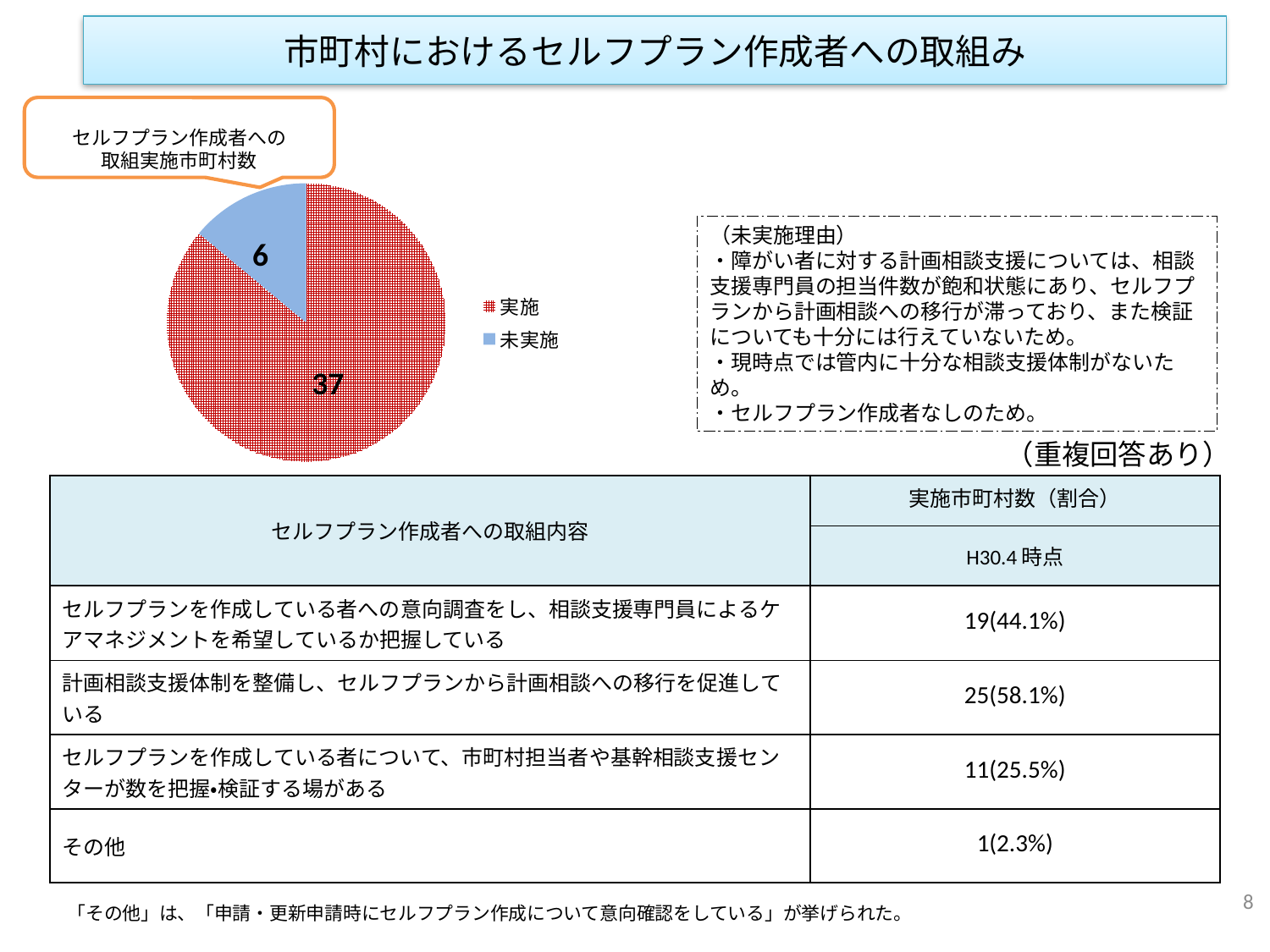
In the pie chart, what is the value for 未実施? 6 How many slices does the pie chart have? 2 Which slice of the pie chart is the largest? 実施 What is the title shown in the callout above the pie chart? セルフプラン作成者への取組実施市町村数 Which slice of the pie chart is the smallest? 未実施 What is the total of the two values shown in the pie chart? 43 What share of the pie chart does the 実施 slice represent? 86.0% How many entries does the pie chart legend list? 2 In the pie chart, what is the value for 実施? 37 What is the difference between the 実施 and 未実施 values in the pie chart? 31 Which is larger in the pie chart, 実施 or 未実施? 実施 What type of chart is shown on the slide? pie chart